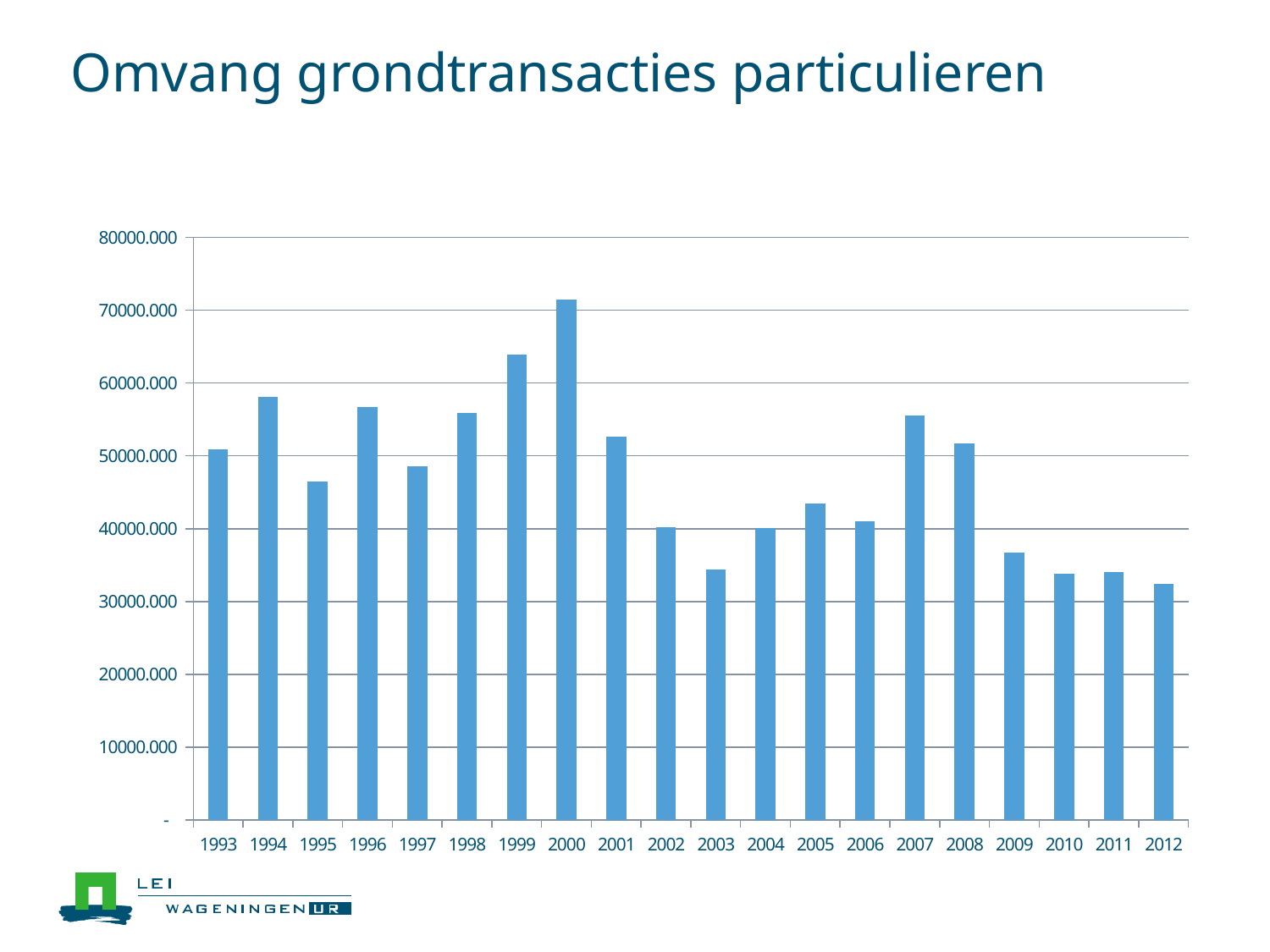
Which year has the larger value, 1993 or 1994? 1994 Is the value for 2009 greater or less than 40000.000? less Which year has the lowest value in the chart? 2012 Which year has the highest value in the chart? 2000 Is the value for 1999 greater or less than 60000.000? greater What is the title of the chart? Omvang grondtransacties particulieren Which year has the larger value, 2007 or 2008? 2007 What kind of chart is shown on the slide? bar chart Is the value for 1995 greater or less than 40000.000? greater Do the values rise or fall from 2008 to 2012? fall How many years are shown on the x axis of the chart? 20